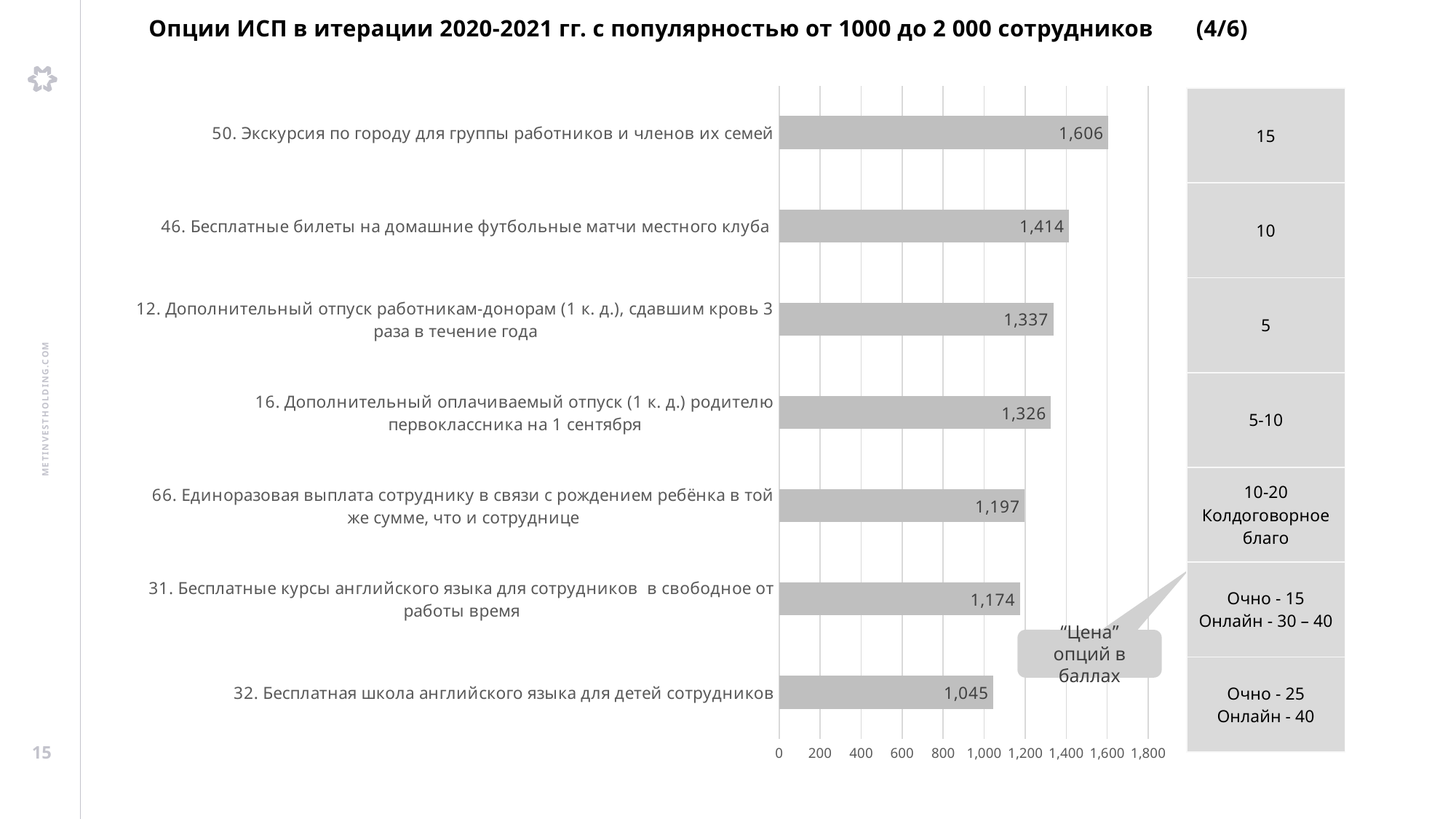
What is the value for option 46 (Бесплатные билеты на домашние футбольные матчи местного клуба)? 1,414 What is the value for option 32 (Бесплатная школа английского языка для детей сотрудников)? 1,045 What kind of chart is shown on the slide? bar chart What is the difference between the highest and lowest values in the chart? 561 Which option has the lowest value in the chart? 32. Бесплатная школа английского языка для детей сотрудников Which has a larger value: option 16 (Дополнительный оплачиваемый отпуск родителю первоклассника) or option 31 (Бесплатные курсы английского языка для сотрудников)? option 16 What is the value for option 50 (Экскурсия по городу для группы работников и членов их семей)? 1,606 What is the 'price' in points shown for option 50 (Экскурсия по городу) in the column to the right of the chart? 15 What is the difference between the values for option 50 and option 46? 192 What is the value for option 66 (Единоразовая выплата сотруднику в связи с рождением ребёнка)? 1,197 Which option has the highest value in the chart? 50. Экскурсия по городу для группы работников и членов их семей How many categories (options) are plotted in the chart? 7